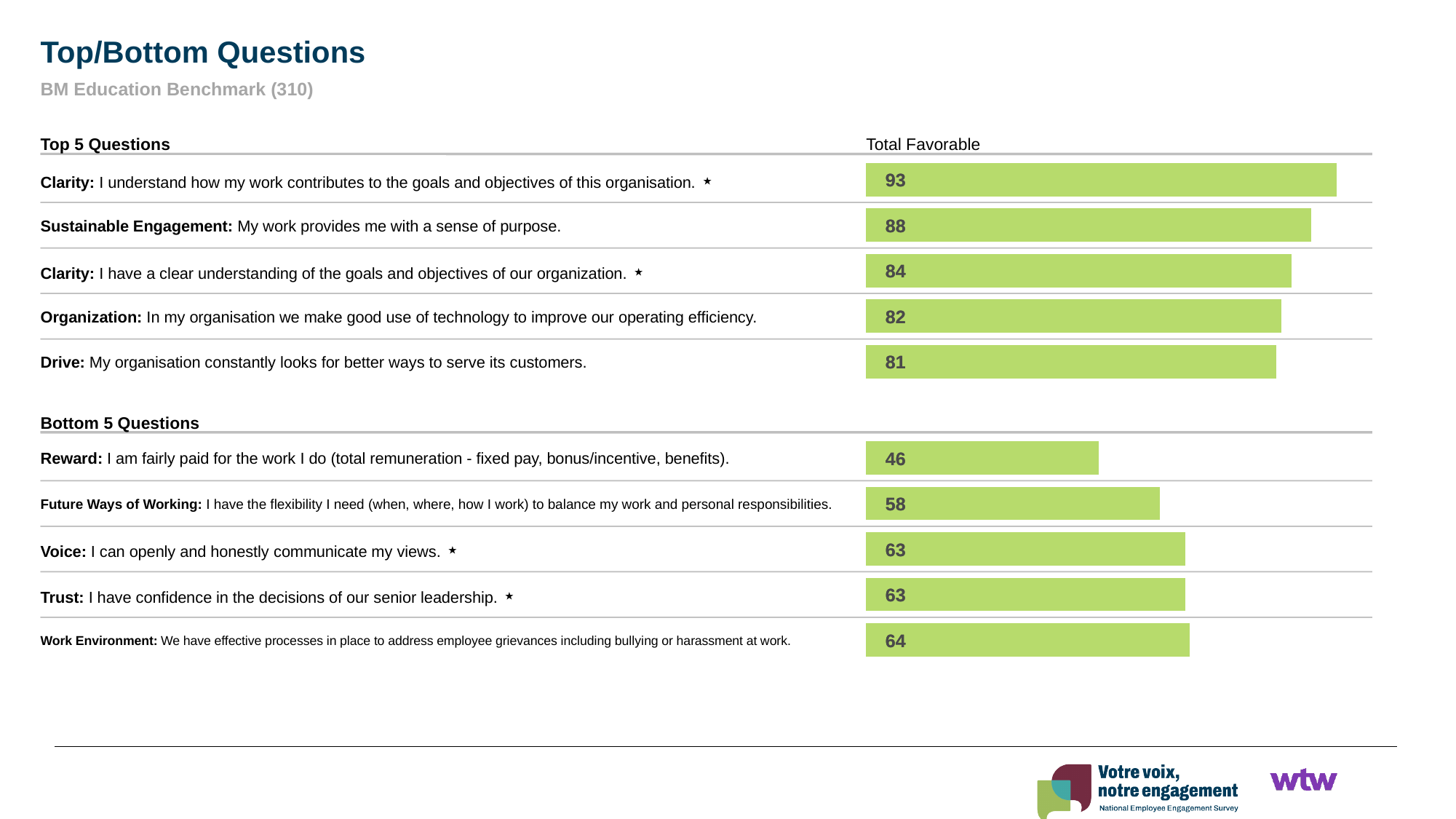
In the Top 5 Questions chart, what is the difference between the Total Favorable values for the Sustainable Engagement item and the Organization item? 6 In the Bottom 5 Questions chart, what is the Total Favorable value for the Reward item? 46 In the Bottom 5 Questions chart, what is the difference between the Total Favorable values for the Work Environment item and the Reward item? 18 In the Top 5 Questions chart, what is the Total Favorable value for the Sustainable Engagement item? 88 In the Bottom 5 Questions chart, what is the Total Favorable value for the Future Ways of Working item? 58 Which has a higher Total Favorable value: the Drive item in the Top 5 Questions chart or the Voice item in the Bottom 5 Questions chart? Drive In the Top 5 Questions chart, which item has the lowest Total Favorable value? Drive: My organisation constantly looks for better ways to serve its customers. In the Bottom 5 Questions chart, which item has the lowest Total Favorable value? Reward: I am fairly paid for the work I do In the Bottom 5 Questions chart, which item has the highest Total Favorable value? Work Environment: We have effective processes in place to address employee grievances including bullying or harassment at work. What type of chart is used to show the Total Favorable values on this slide? Bar chart How many items are shown in the Bottom 5 Questions chart? 5 In the Top 5 Questions chart, what is the Total Favorable value for the Clarity item 'I understand how my work contributes to the goals and objectives of this organisation'? 93